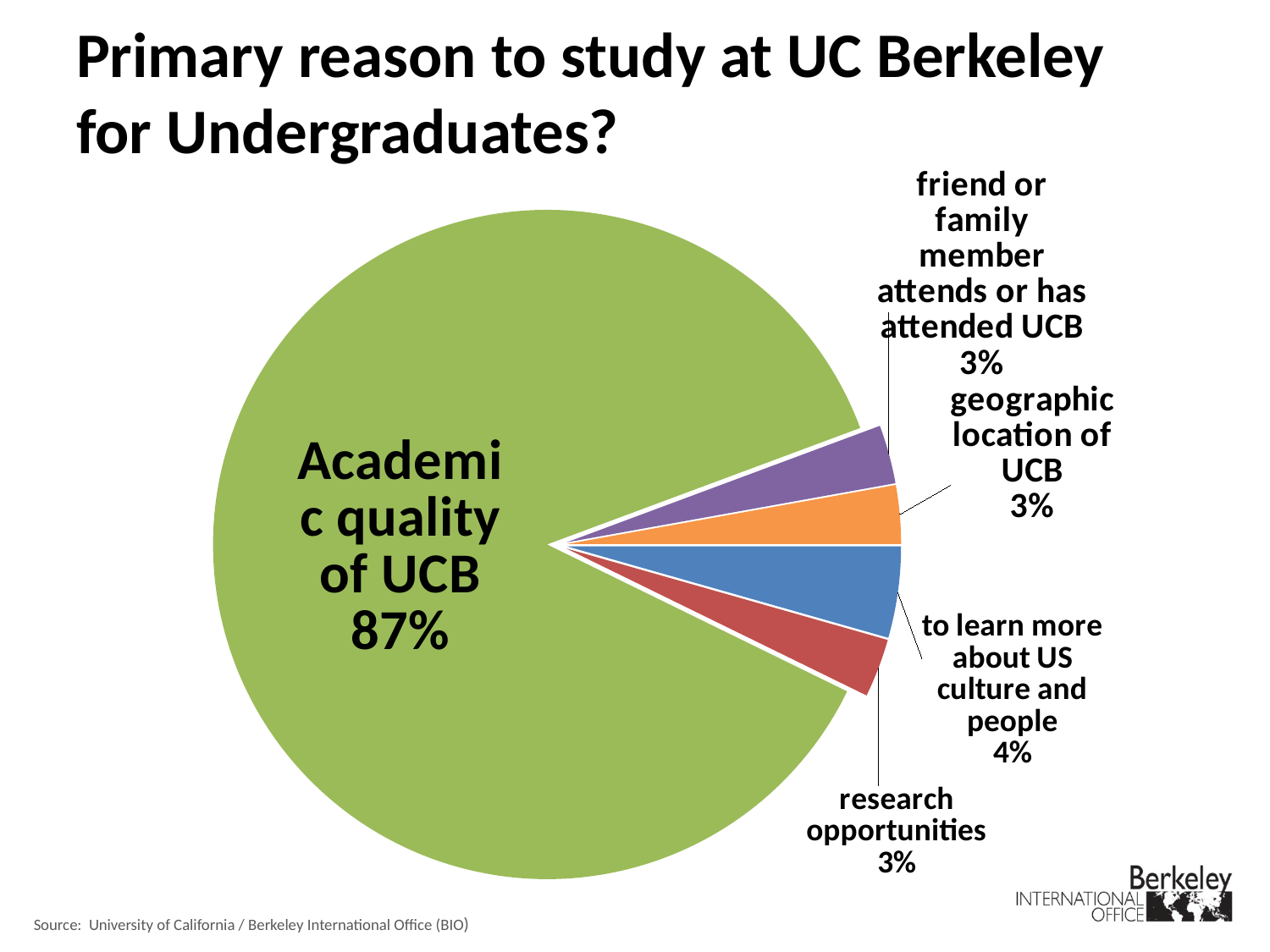
What is the difference in percentage points between "Academic quality of UCB" and "to learn more about US culture and people"? 83 percentage points What colour is the slice for "Academic quality of UCB"? Green What percentage is shown for "research opportunities"? 3% Which is larger: the share for "to learn more about US culture and people" or the share for "research opportunities"? to learn more about US culture and people What percentage is shown for "friend or family member attends or has attended UCB"? 3% What percentage is shown for "to learn more about US culture and people"? 4% Which category has the largest share of the pie? Academic quality of UCB What percentage is shown for "geographic location of UCB"? 3% What share of the pie does "Academic quality of UCB" account for? 87% How many categories are shown in the pie chart? 5 What is the title of the slide? Primary reason to study at UC Berkeley for Undergraduates? What kind of chart is shown on the slide? Pie chart